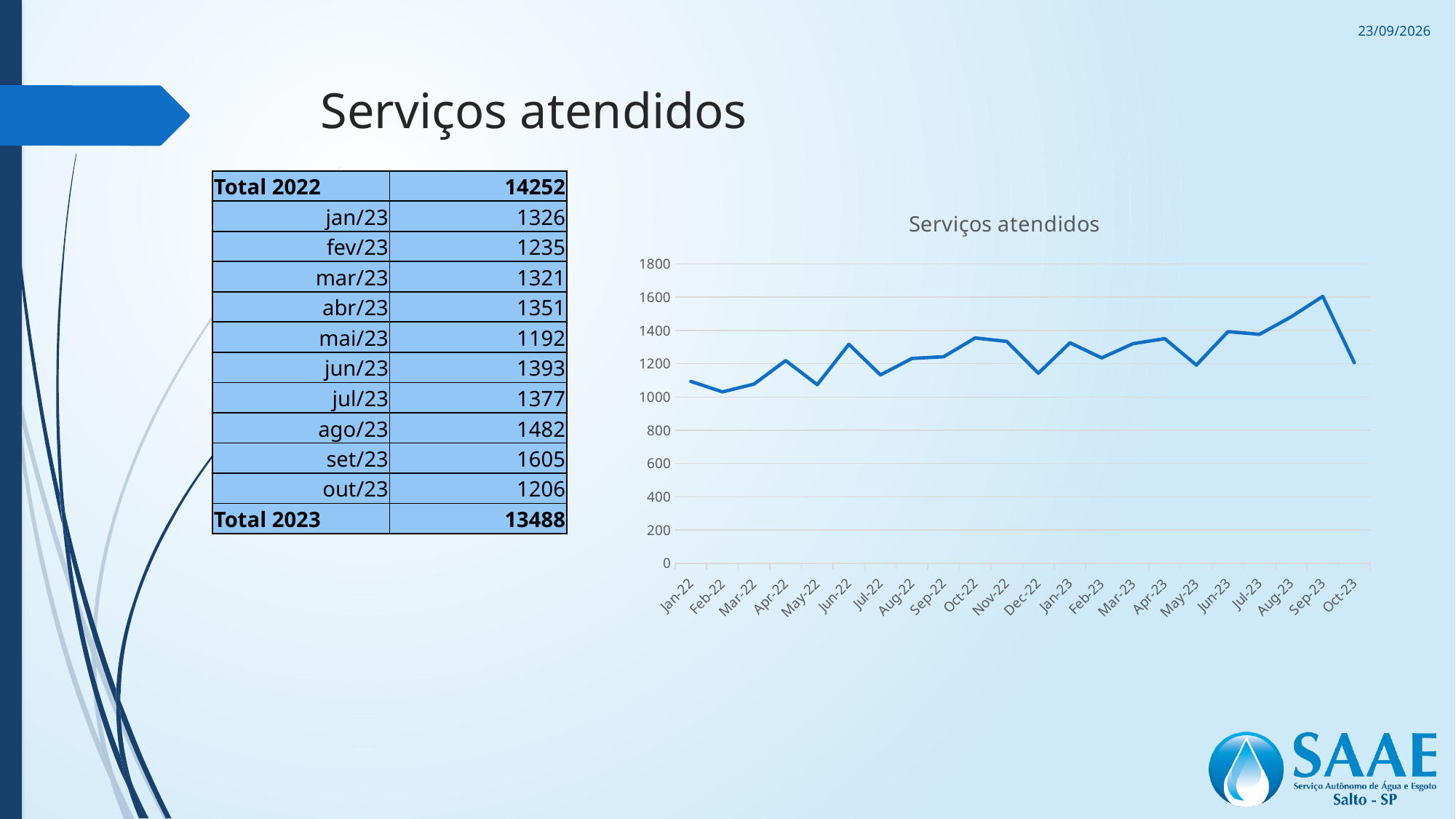
What is the title of the line chart? Serviços atendidos What kind of chart is shown on the slide? line chart What is the value for Aug-23 (ago/23)? 1482 Which month has the lowest value on the line chart? Feb-22 What is the value for Sep-23 (set/23)? 1605 Which is larger, the value for Jun-22 or the value for Jul-22? Jun-22 Do the values rise or fall from Jul-23 to Sep-23? rise What is the difference between the values for Sep-23 and Oct-23? 399 How many monthly data points are plotted on the line chart? 22 Is the value for Jan-22 greater or less than 1200? less Is the value for Oct-22 greater or less than 1200? greater Which month has the highest value on the line chart? Sep-23